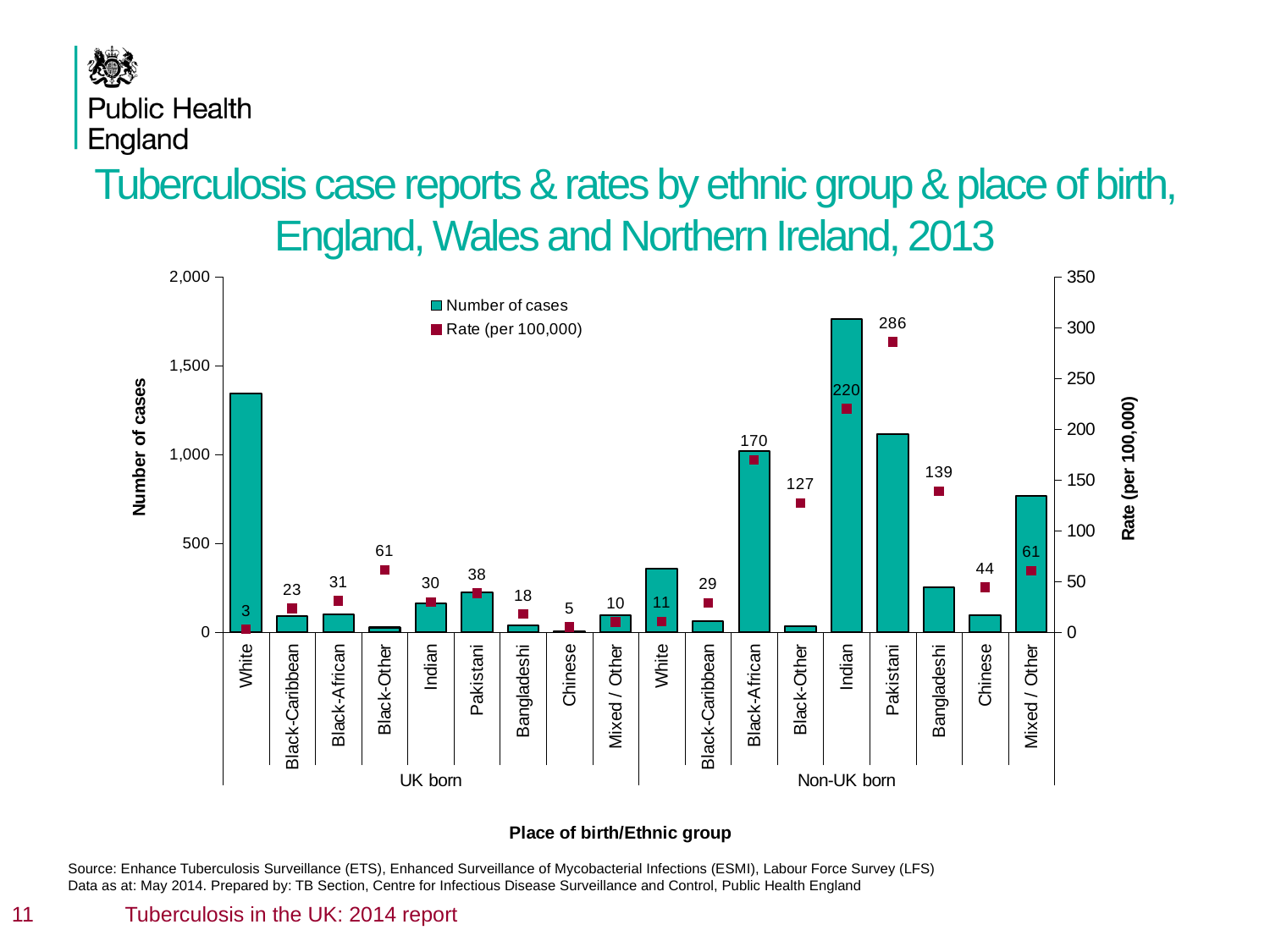
What is the rate (per 100,000) for the Non-UK born Pakistani group? 286 What is the difference between the rate (per 100,000) for Non-UK born Indian and Non-UK born Black-African? 50 What is the rate (per 100,000) for the UK born Black-Other group? 61 Is the number of cases for the Non-UK born White group greater or less than 500? less Which group has the highest rate (per 100,000)? Non-UK born Pakistani What is the rate (per 100,000) for the Non-UK born Black-Other group? 127 Is the number of cases for the Non-UK born Indian group greater or less than 1,500? greater Which has the higher rate (per 100,000): UK born Pakistani or UK born Black-African? UK born Pakistani Is the number of cases for the UK born White group greater or less than 1,000? greater What is the title of the right-hand vertical axis? Rate (per 100,000) How many series does the legend list? 2 Which group has the lowest rate (per 100,000)? UK born White